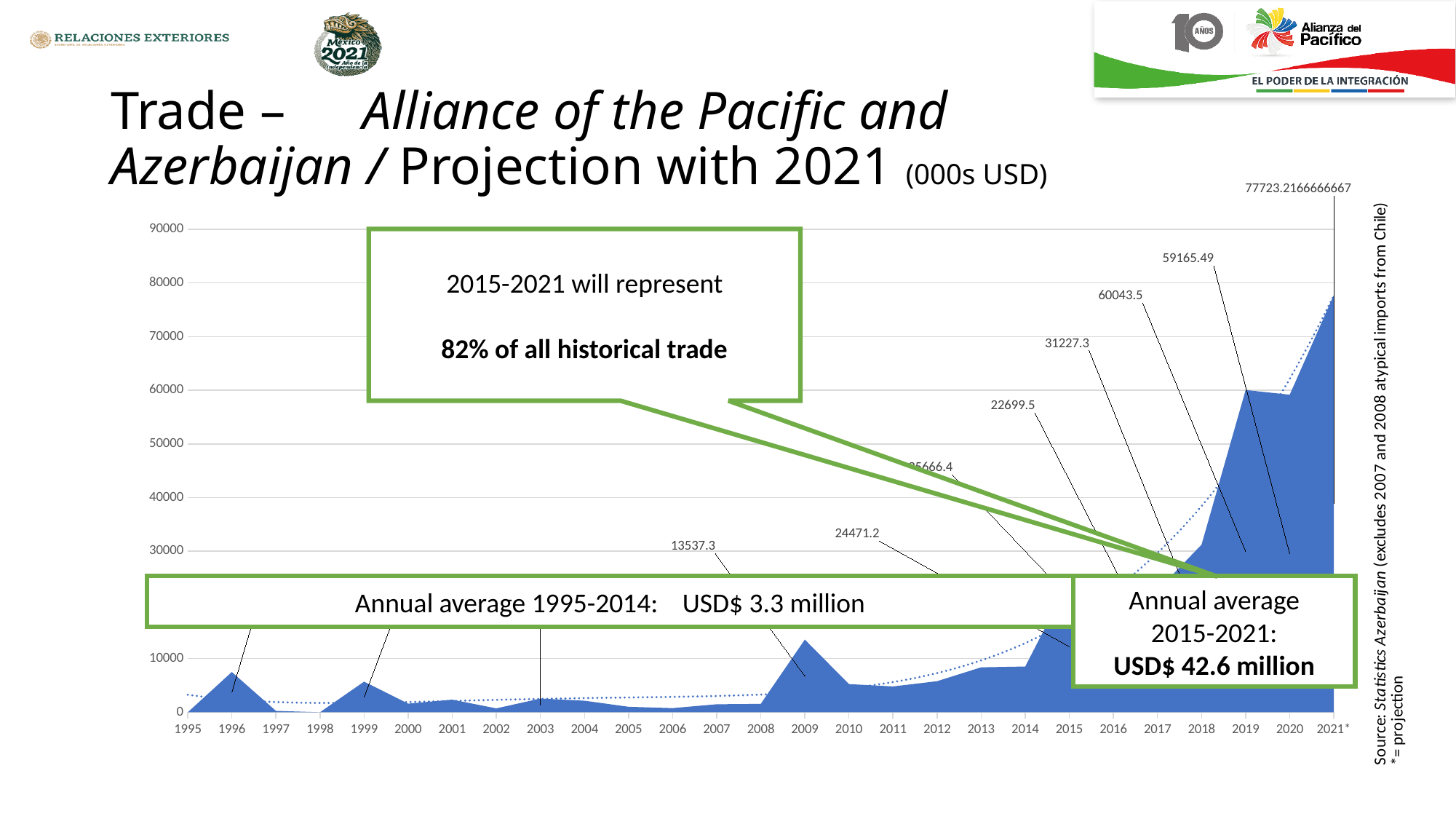
Is the trade value for 1996 greater or less than 10000? less What is the difference between the trade values for 2019 and 2020? 878.01 What is the trade value for 2020? 59165.49 How many years are shown on the x axis of the chart? 27 What is the projected trade value for 2021*? 77723.2166666667 Is the trade value for 2009 greater or less than 10000? greater What kind of chart is shown on the slide? area chart What is the trade value for 2018? 31227.3 Which year has the highest trade value on the chart? 2021* Which year has the larger trade value, 2019 or 2020? 2019 What is the trade value for 2019? 60043.5 According to the callout on the chart, what is the annual average trade for 2015-2021? USD$ 42.6 million